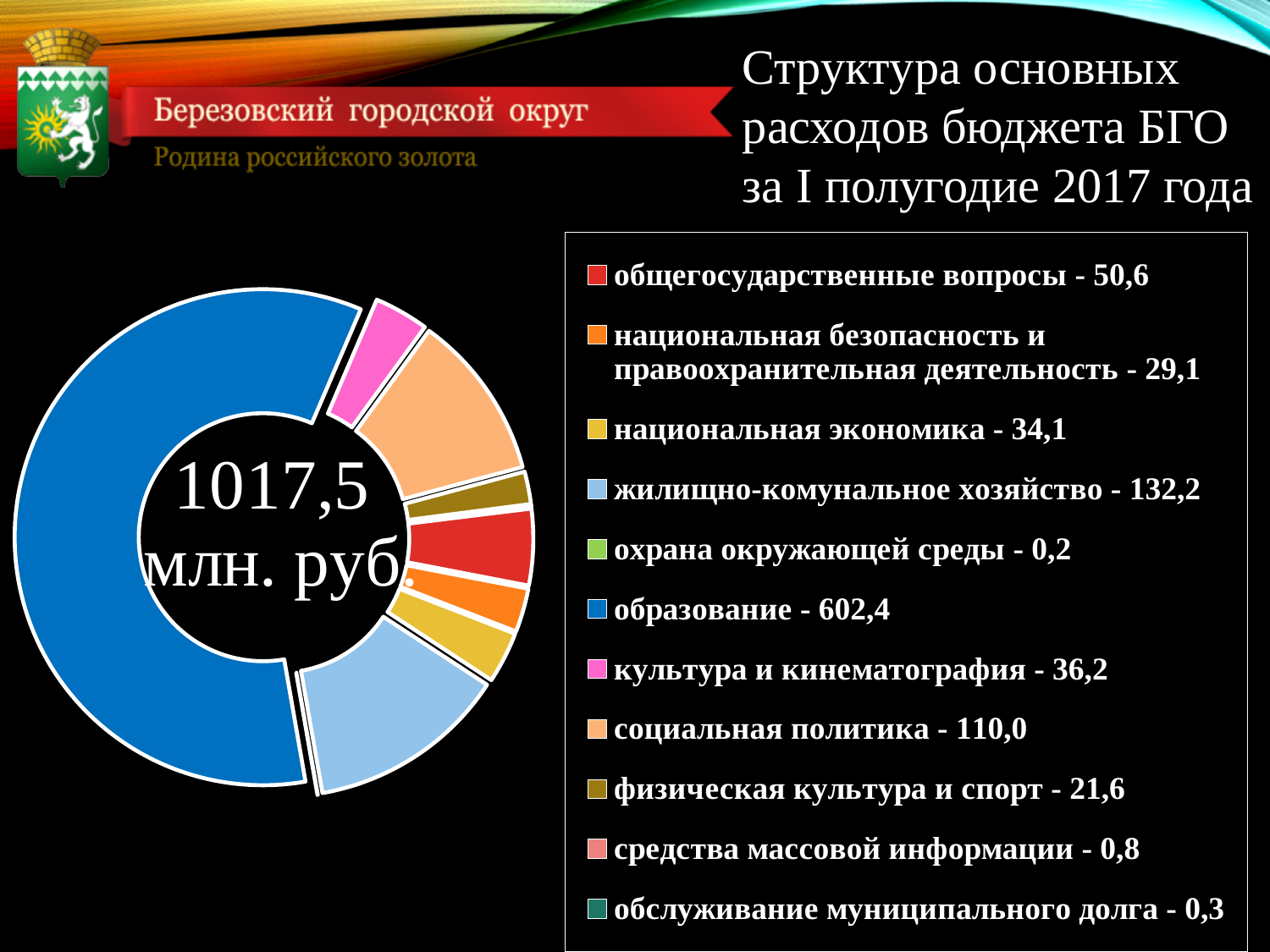
What is the difference between the values for жилищно-комунальное хозяйство and социальная политика? 22,2 What colour represents образование in the chart? blue How many categories does the legend list? 11 What total is printed in the centre of the chart? 1017,5 млн. руб. Which is larger: национальная экономика or национальная безопасность и правоохранительная деятельность? национальная экономика Which category has the largest value in the chart? образование What value does the legend give for жилищно-комунальное хозяйство? 132,2 Which category has the smallest value in the chart? охрана окружающей среды What value does the legend give for социальная политика? 110,0 What value does the legend give for образование? 602,4 What kind of chart is shown on the slide? doughnut (pie) chart What value does the legend give for физическая культура и спорт? 21,6